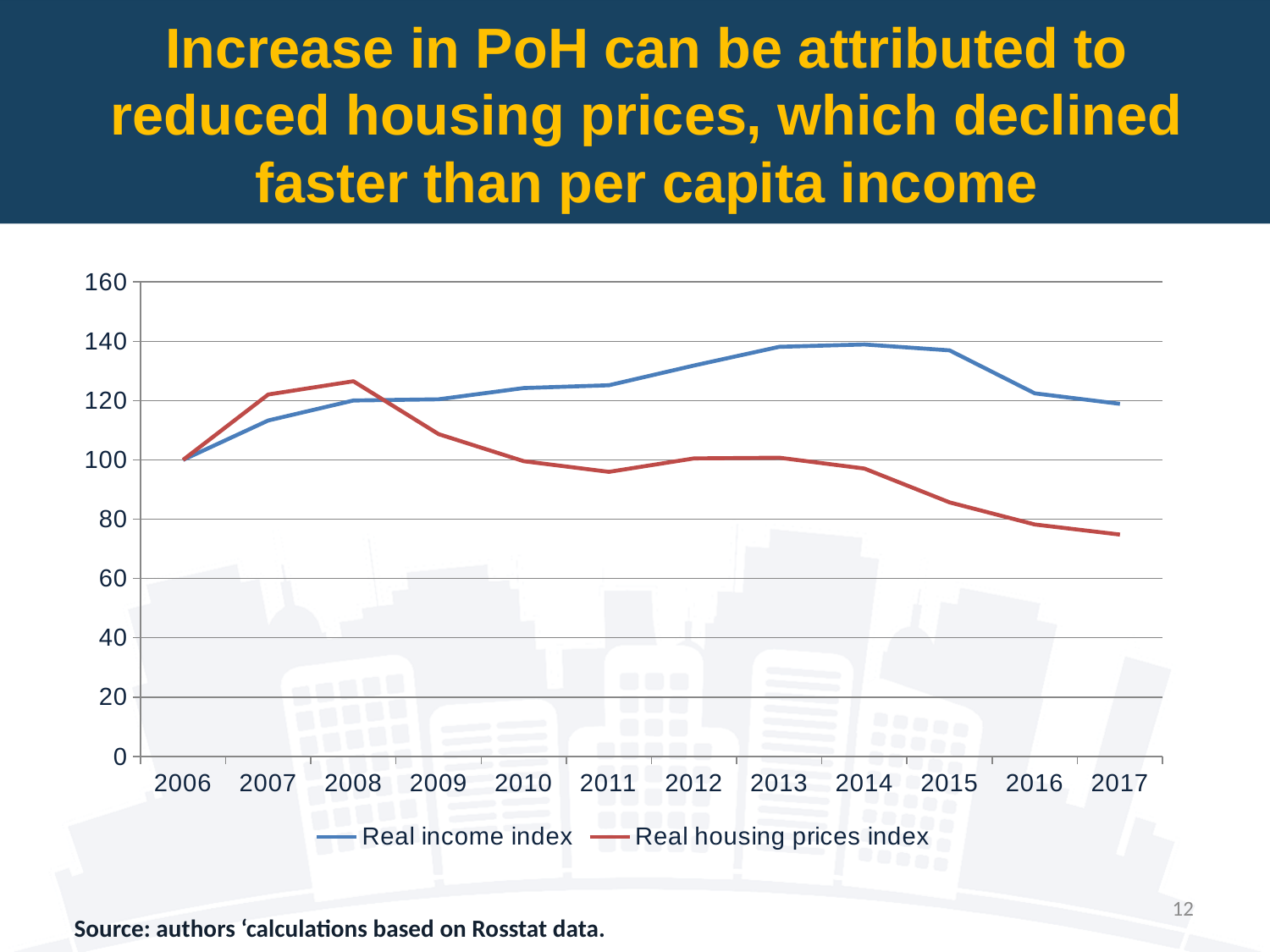
Does the Real housing prices index rise or fall from 2008 to 2017? Fall What is the value of the Real income index in 2006? 100 How many series does the legend list? 2 What kind of chart is shown on the slide? Line chart Is the value of the Real income index in 2013 greater or less than 120? greater Which series is drawn in red? Real housing prices index Which series has the larger value in 2017, Real income index or Real housing prices index? Real income index What is the value of the Real housing prices index in 2006? 100 Is the value of the Real housing prices index in 2017 greater or less than 80? less In which year is the Real housing prices index lowest? 2017 In which year is the Real housing prices index highest? 2008 How many years are shown on the x axis? 12